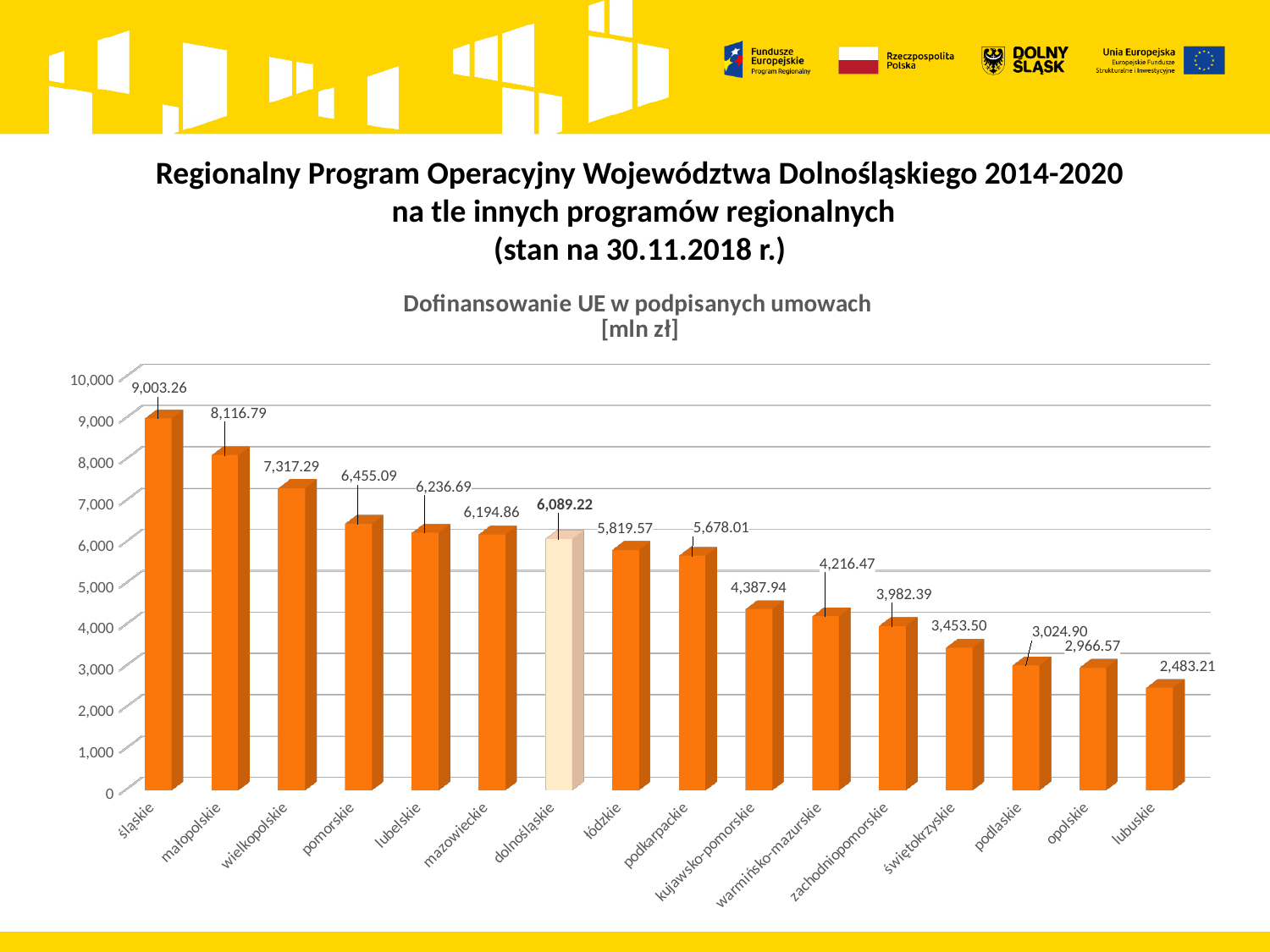
What is the difference between the values for dolnośląskie and łódzkie? 269.65 What is the difference between the values for śląskie and małopolskie? 886.47 What is the value for śląskie? 9,003.26 What is the value for lubuskie? 2,483.21 Which has a larger value, pomorskie or lubelskie? pomorskie Which voivodeship has the lowest value? lubuskie Which voivodeship has the highest value? śląskie What is the value for dolnośląskie? 6,089.22 Do the values rise or fall from left to right along the x axis? fall What kind of chart is shown? bar chart How many voivodeships are shown on the chart? 16 What is the value for kujawsko-pomorskie? 4,387.94